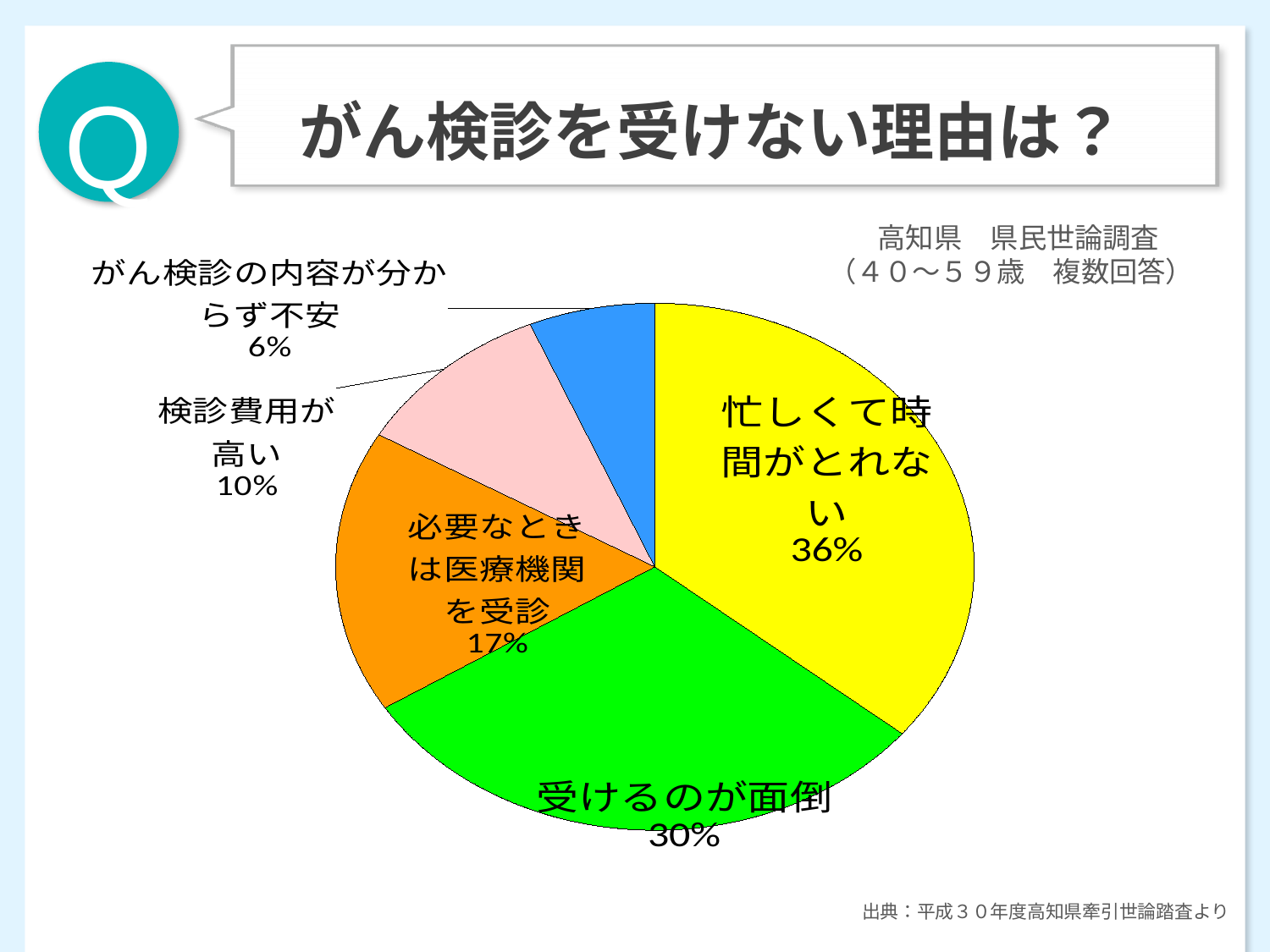
How many slices does the pie chart have? 5 What percentage is shown for 必要なときは医療機関を受診? 17% What percentage is shown for 忙しくて時間がとれない? 36% What kind of chart is shown on the slide? pie chart What is the difference in percentage points between 忙しくて時間がとれない and 受けるのが面倒? 6 Which reason has the smallest share of the pie? がん検診の内容が分からず不安 Which reason has the largest share of the pie? 忙しくて時間がとれない Which is larger, the share for 必要なときは医療機関を受診 or the share for 検診費用が高い? 必要なときは医療機関を受診 What percentage is shown for 検診費用が高い? 10% What percentage is shown for がん検診の内容が分からず不安? 6% What is the title of the question shown above the chart? がん検診を受けない理由は？ What percentage is shown for 受けるのが面倒? 30%